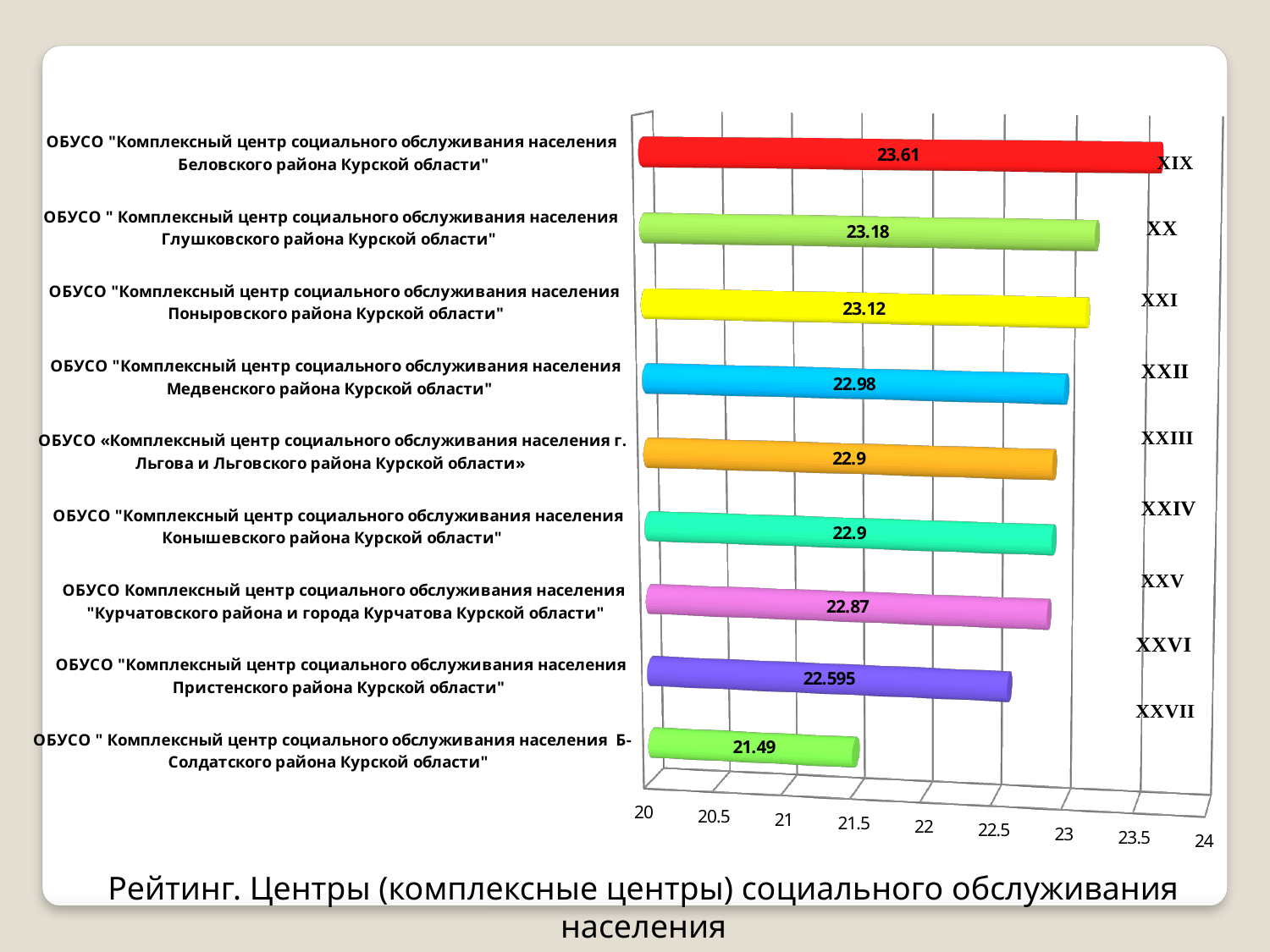
What value is shown for the centre of Медвенского района Курской области? 22.98 How many centres (bars) are shown on the chart? 9 What value is shown for the centre of Пристенского района Курской области? 22.595 What value is shown for ОБУСО "Комплексный центр социального обслуживания населения Беловского района Курской области"? 23.61 Which has a larger value: the Курчатовского района centre or the Пристенского района centre? Курчатовского района centre (22.87) What is the difference between the values for the Беловского района centre and the Б-Солдатского района centre? 2.12 Is the value for the Б-Солдатского района centre greater or less than 22? less What type of chart is shown on the slide? Bar chart Which centre has the lowest value on the chart? ОБУСО "Комплексный центр социального обслуживания населения Б-Солдатского района Курской области" What is the difference between the values for the Глушковского района centre and the Поныровского района centre? 0.06 Which centre has the highest value on the chart? ОБУСО "Комплексный центр социального обслуживания населения Беловского района Курской области" What is the title of the chart on the slide? Рейтинг. Центры (комплексные центры) социального обслуживания населения